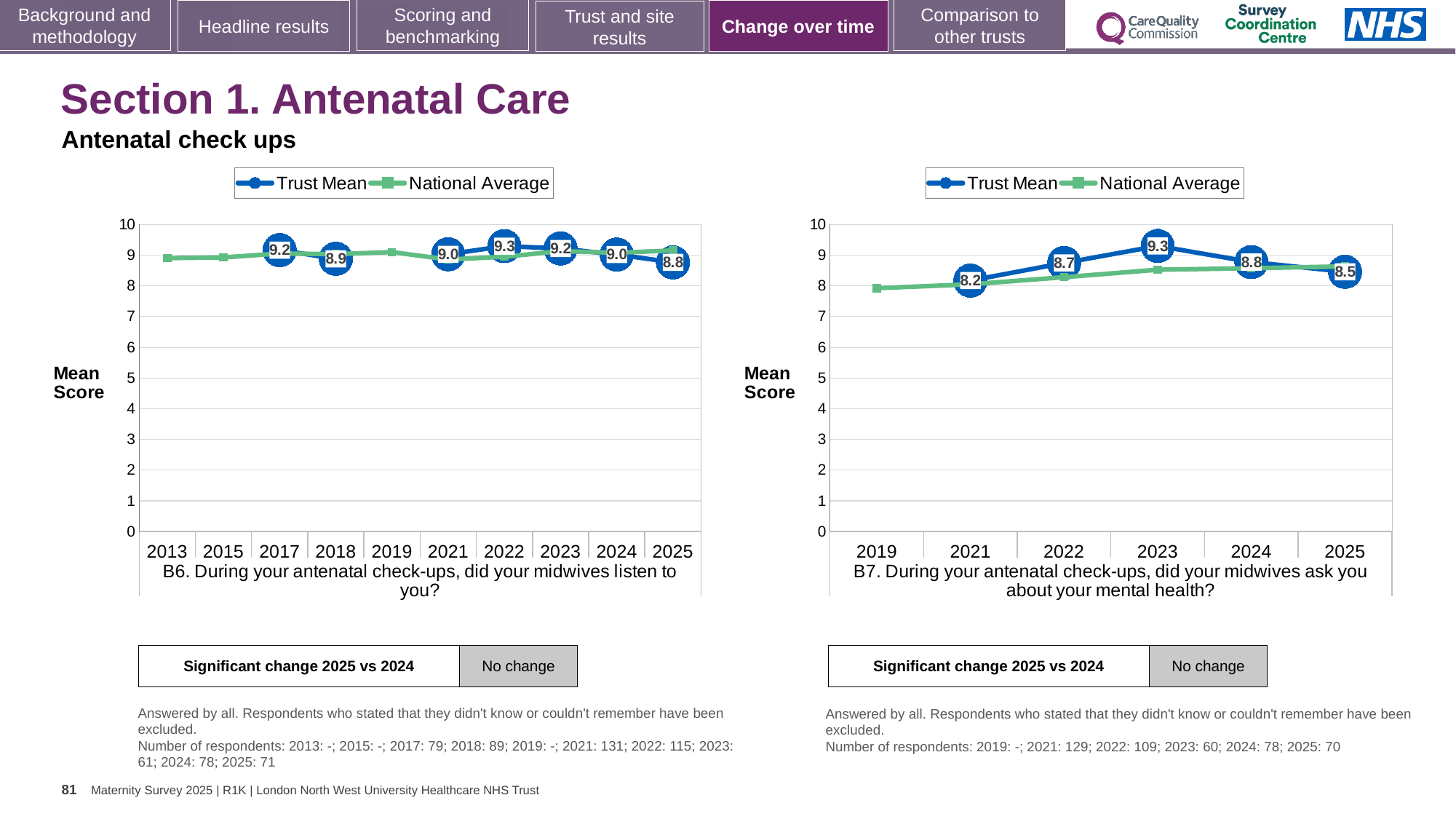
In the B7 chart (right), what is the Trust Mean for 2021? 8.2 In the B6 chart (left), what is the Trust Mean for 2025? 8.8 How many years are shown on the x axis of the B6 chart (left)? 10 What kind of chart is the B6 chart (left)? Line chart In the B6 chart (left), which is larger, the Trust Mean for 2017 or for 2018? 2017 In the B7 chart (right), is the National Average for 2019 greater or less than 9? less How many series does the legend of the B7 chart (right) list? 2 In the B7 chart (right), what is the difference between the Trust Mean in 2023 and in 2025? 0.8 In the B6 chart (left), what is the Trust Mean for 2022? 9.3 In the B7 chart (right), which year has the highest Trust Mean? 2023 In the B7 chart (right), which year has the lowest Trust Mean? 2021 In the B7 chart (right), does the Trust Mean rise or fall from 2023 to 2025? Fall